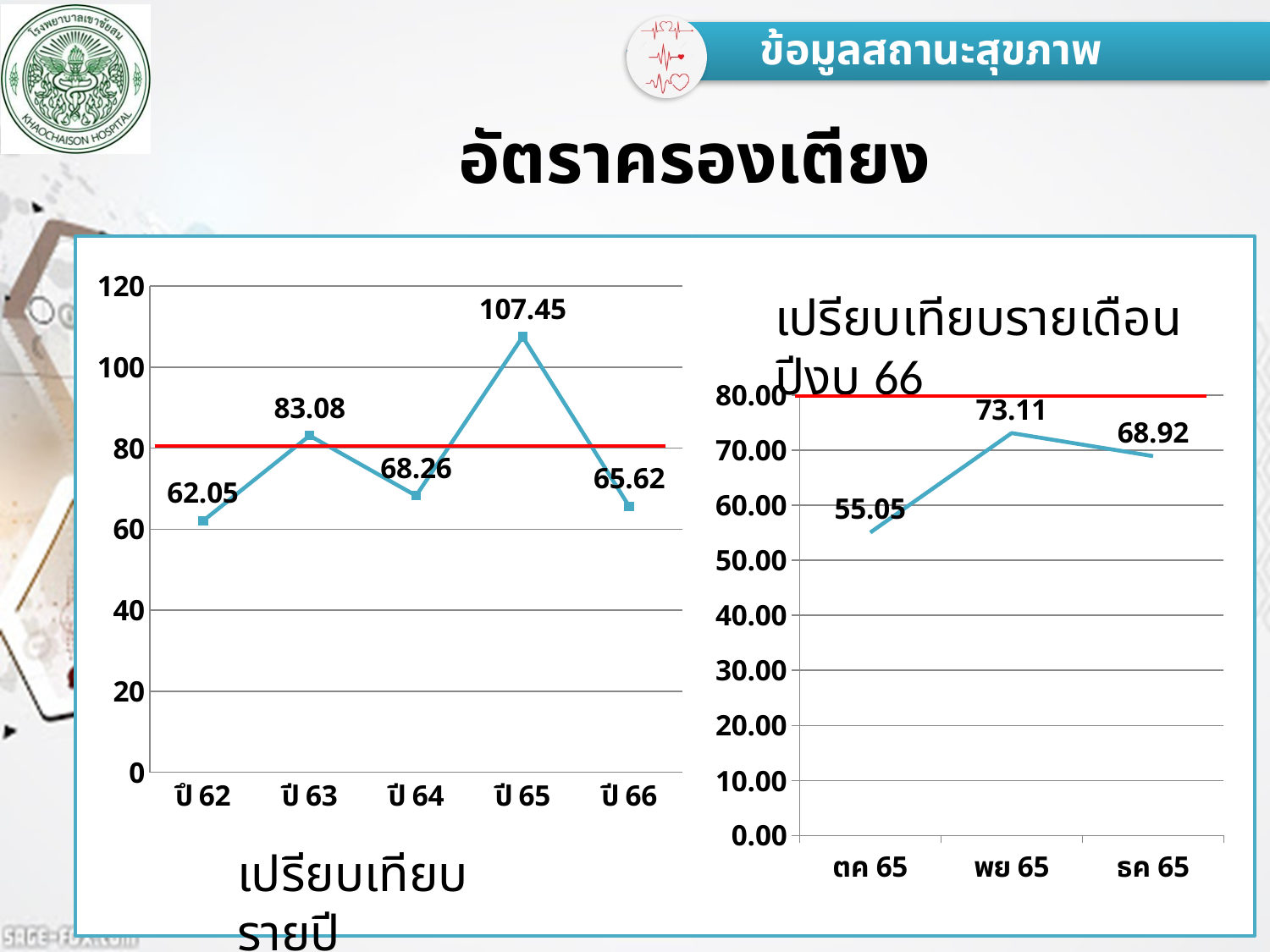
In the left chart (เปรียบเทียบรายปี), which year has the highest value? ปี 65 In the left chart (เปรียบเทียบรายปี), which year has the lowest value? ปี 62 In the left chart (เปรียบเทียบรายปี), what is the value for ปี 65? 107.45 In the right chart (เปรียบเทียบรายเดือน ปีงบ 66), what is the value for พย 65? 73.11 In the right chart (เปรียบเทียบรายเดือน ปีงบ 66), what is the difference between the values for พย 65 and ตค 65? 18.06 In the right chart (เปรียบเทียบรายเดือน ปีงบ 66), which month has the lowest value? ตค 65 What kind of chart is the right chart (เปรียบเทียบรายเดือน ปีงบ 66)? line chart In the left chart (เปรียบเทียบรายปี), what is the difference between the values for ปี 65 and ปี 64? 39.19 In the left chart (เปรียบเทียบรายปี), what is the value for ปี 62? 62.05 In the left chart (เปรียบเทียบรายปี), which is larger, the value for ปี 63 or the value for ปี 66? ปี 63 In the left chart (เปรียบเทียบรายปี), how many years are plotted on the x axis? 5 In the right chart (เปรียบเทียบรายเดือน ปีงบ 66), is the value for ธค 65 greater or less than 80.00? less